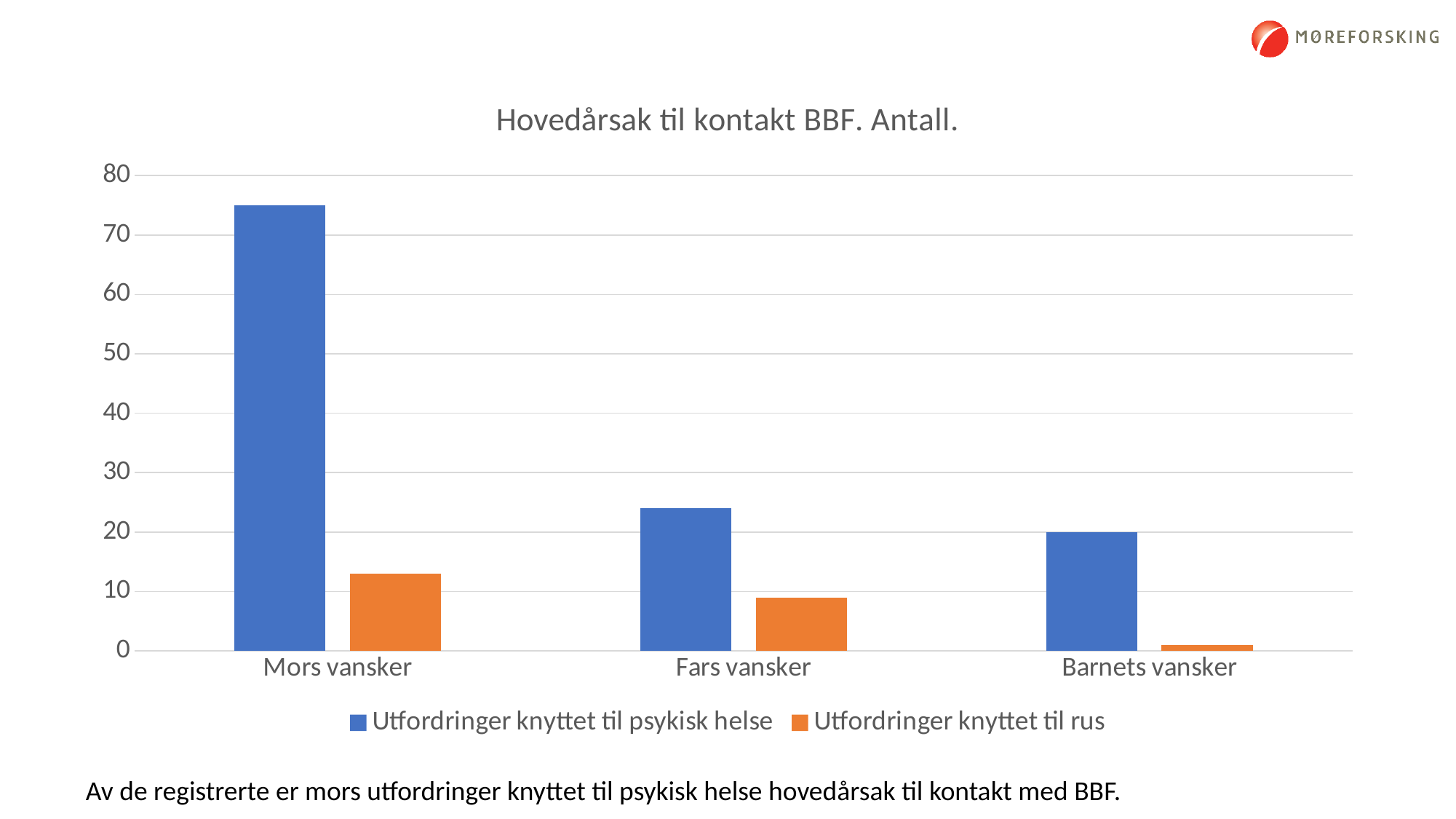
How many series does the legend list? 2 Is the value for Utfordringer knyttet til psykisk helse at Mors vansker greater or less than 70? greater Which category has the highest value for Utfordringer knyttet til psykisk helse? Mors vansker What is the title of the chart? Hovedårsak til kontakt BBF. Antall. Is the value for Utfordringer knyttet til rus at Fars vansker greater or less than 10? less Do the values for Utfordringer knyttet til rus rise or fall from Mors vansker to Barnets vansker? fall What type of chart is shown on the slide? bar chart How many categories are shown on the x axis? 3 Which colour represents Utfordringer knyttet til rus in the chart? orange Which is larger: Utfordringer knyttet til psykisk helse for Fars vansker or for Barnets vansker? Fars vansker Is the value for Utfordringer knyttet til rus at Mors vansker greater or less than 10? greater Which category has the lowest value for Utfordringer knyttet til rus? Barnets vansker